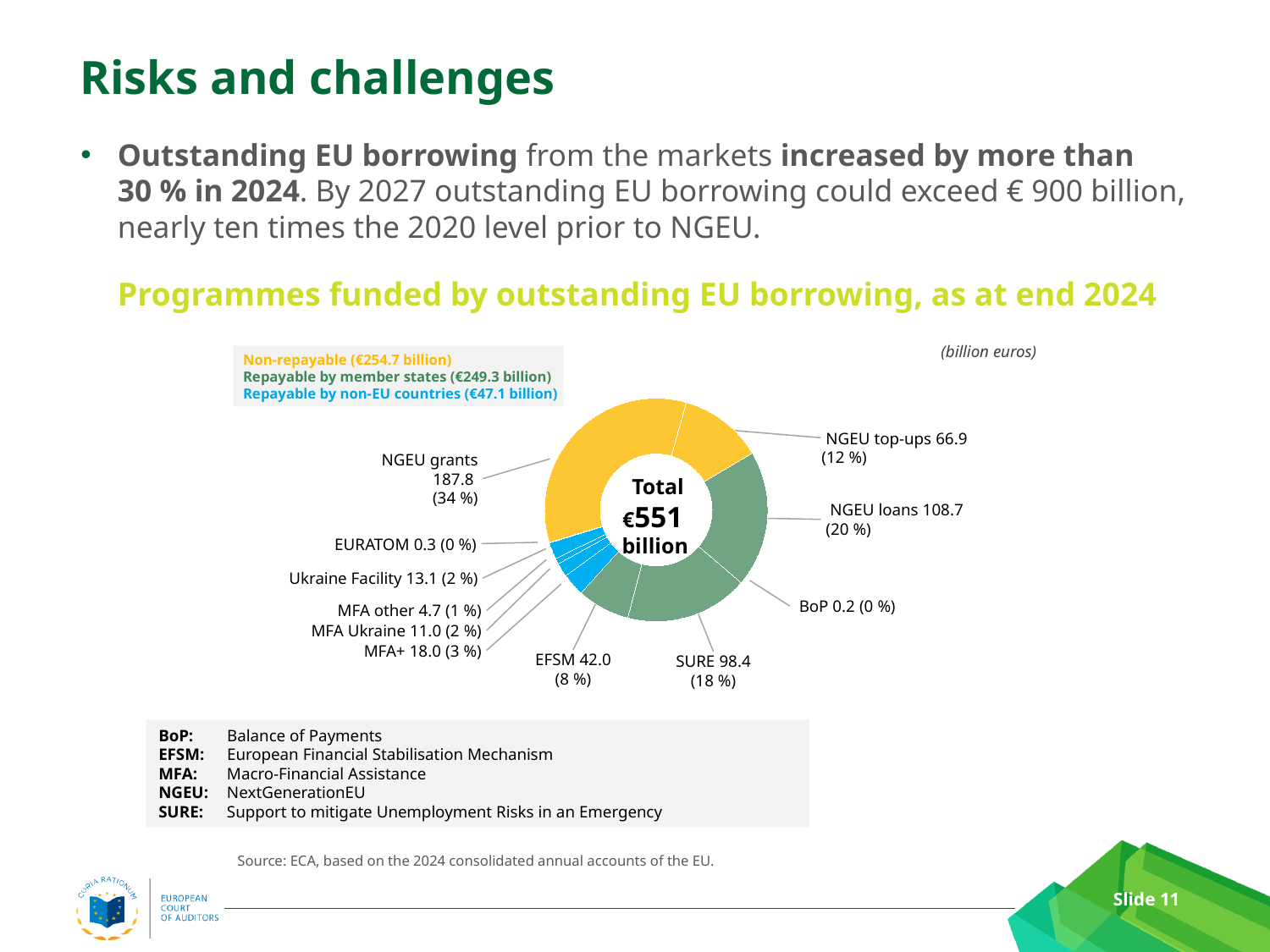
What is the difference between NGEU loans and SURE? 10.3 What is the value for NGEU loans? 108.7 Which is larger, MFA+ or Ukraine Facility? MFA+ Which programme has the smallest value in the chart? BoP What total is shown in the centre of the chart? €551 billion Which programme has the largest share of outstanding EU borrowing? NGEU grants What is the value for SURE? 98.4 What share of the total does NGEU top-ups represent? 12 % How many programmes are shown in the chart? 11 What share of the total does EFSM represent? 8 % What kind of chart is shown on the slide? Pie chart (donut) What is the value for NGEU grants? 187.8